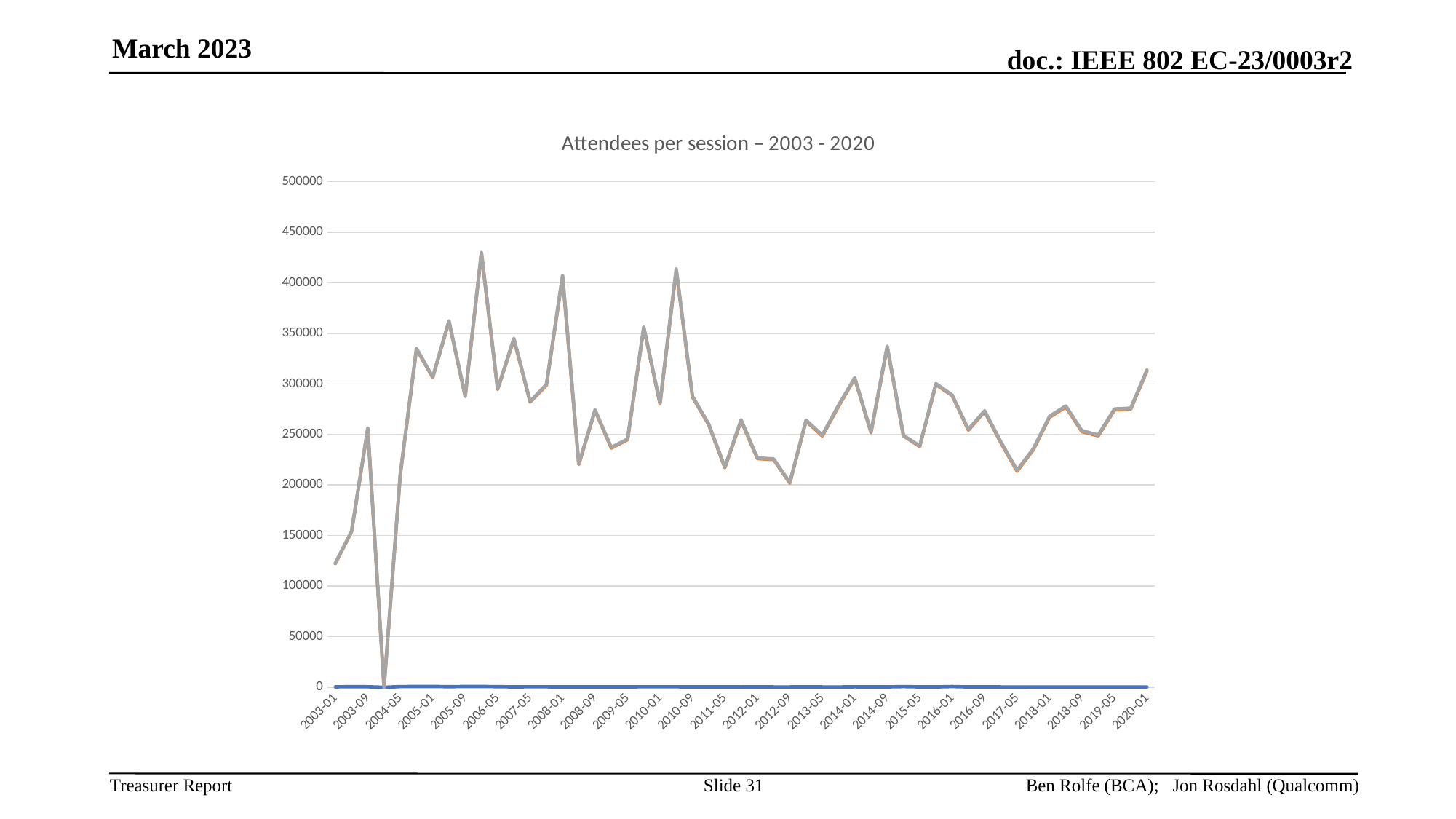
What is the highest value shown on the vertical axis of the chart? 500000 What kind of chart is shown on the slide? line chart Is the value for 2020-01 greater or less than 350000? less What is the title of the chart? Attendees per session – 2003 - 2020 Do the values rise or fall between 2003-01 and 2003-09? rise Is the value for 2003-01 greater or less than 100000? greater Is the value for 2003-01 greater or less than 150000? less How many labels are printed along the x axis of the chart? 26 What is the first label on the x axis of the chart? 2003-01